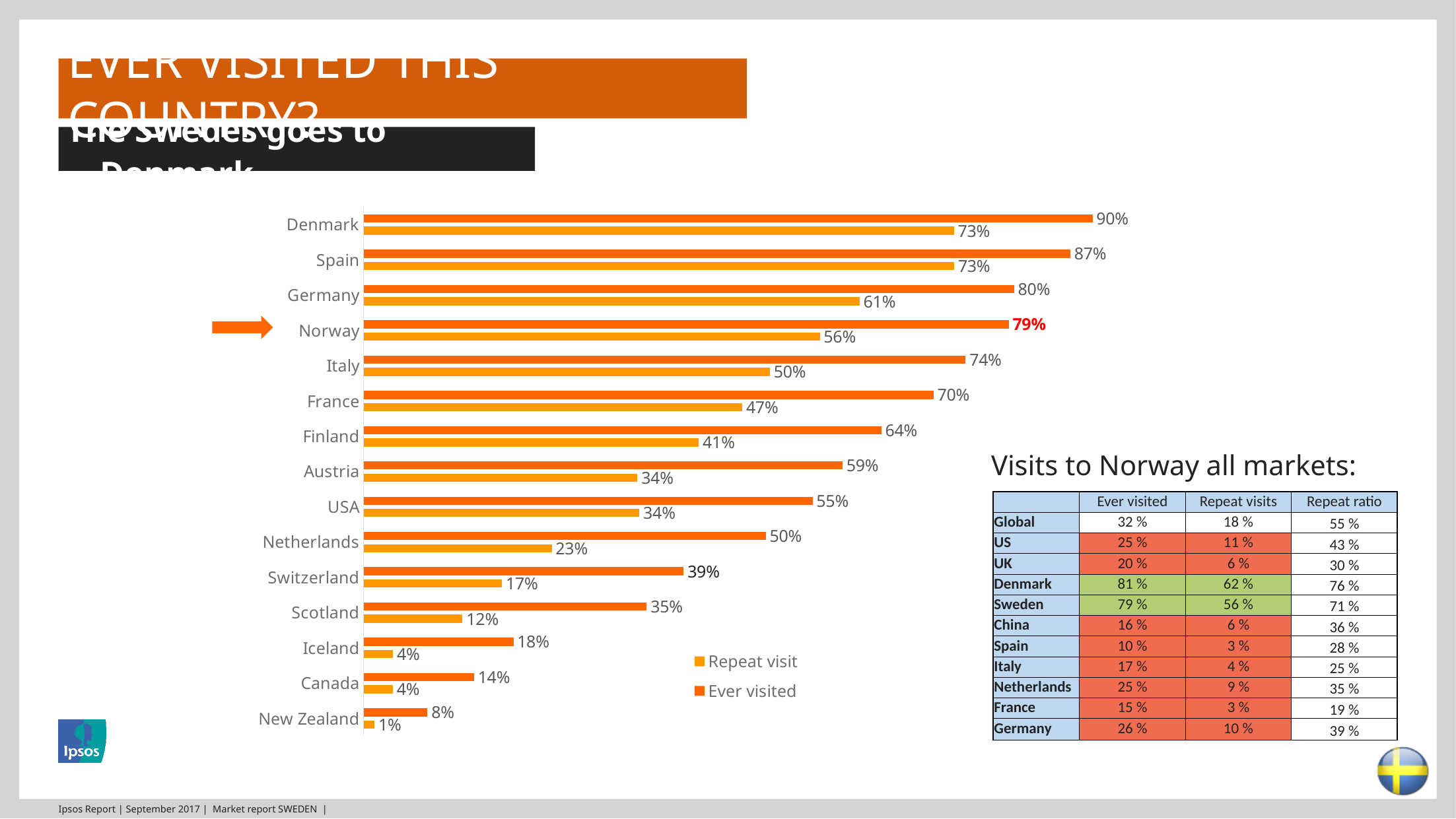
What is the 'Repeat visit' value for Germany? 61% How many series does the chart legend list? 2 What is the 'Ever visited' value for Finland? 64% How many countries are shown in the bar chart? 15 What is the 'Ever visited' value for Norway? 79% What kind of chart is shown on the slide? Bar chart What is the difference between the 'Ever visited' values for Denmark and Spain? 3% Which country has the lowest 'Repeat visit' value? New Zealand Which series in the legend is shown in the lighter orange colour? Repeat visit Which is larger: the 'Ever visited' value for Switzerland or the 'Ever visited' value for Scotland? Switzerland Which country has the highest 'Ever visited' value? Denmark What is the difference between the 'Ever visited' and 'Repeat visit' values for Italy? 24%